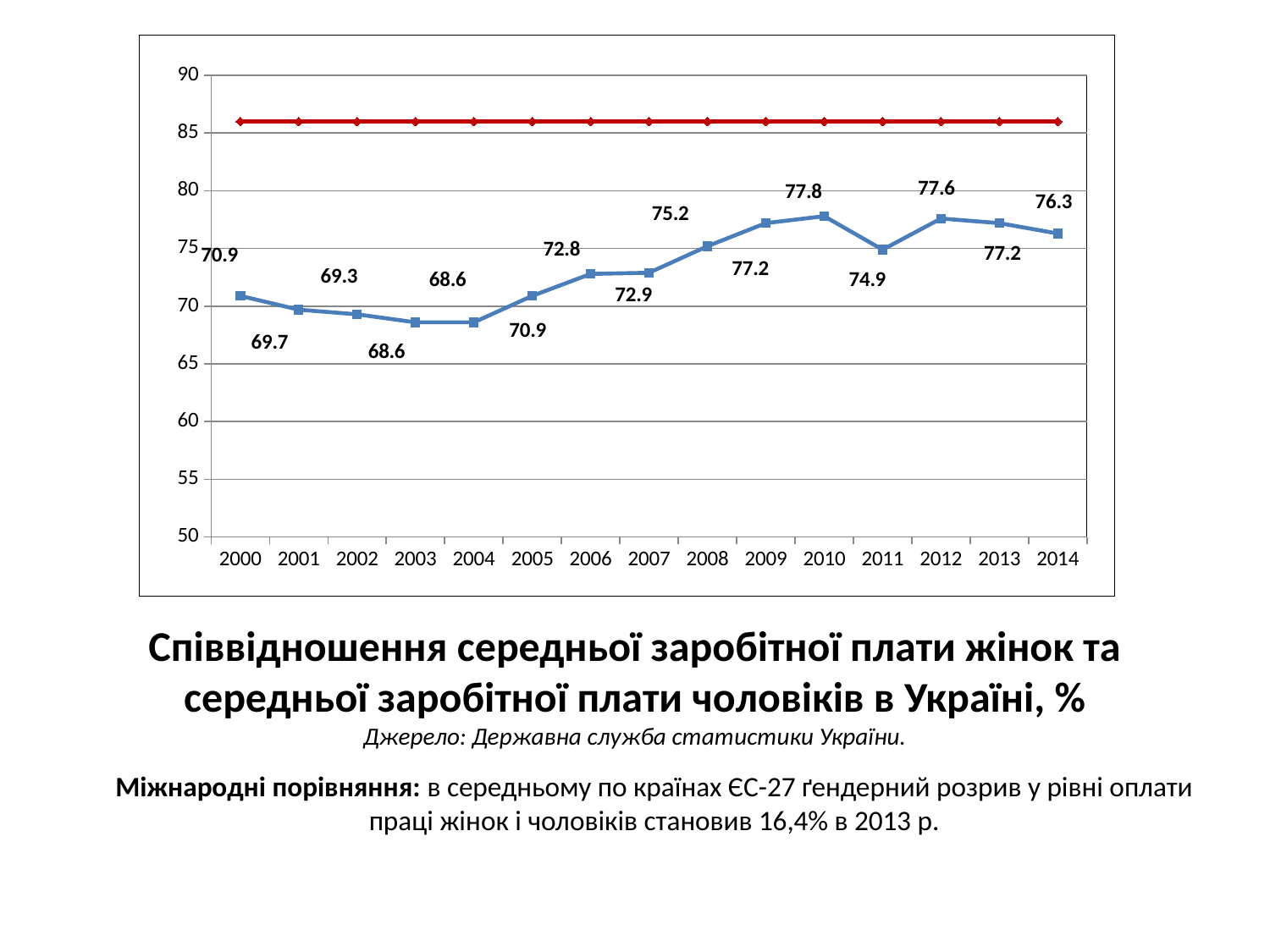
By how much does the blue line's value for 2014 exceed its value for 2000? 5.4 Does the blue line rise or fall from 2000 to 2004? fall What is the value of the blue line for 2011? 74.9 Which year has the larger value on the blue line, 2008 or 2011? 2008 Is the value of the red line greater or less than 85? greater How many years are shown on the x axis? 15 What is the value of the blue line for 2014? 76.3 What is the value of the blue line for 2000? 70.9 In which year does the blue line reach its highest value? 2010 What is the value of the blue line for 2010? 77.8 What kind of chart is shown on the slide? line chart What is the lowest value shown on the blue line? 68.6